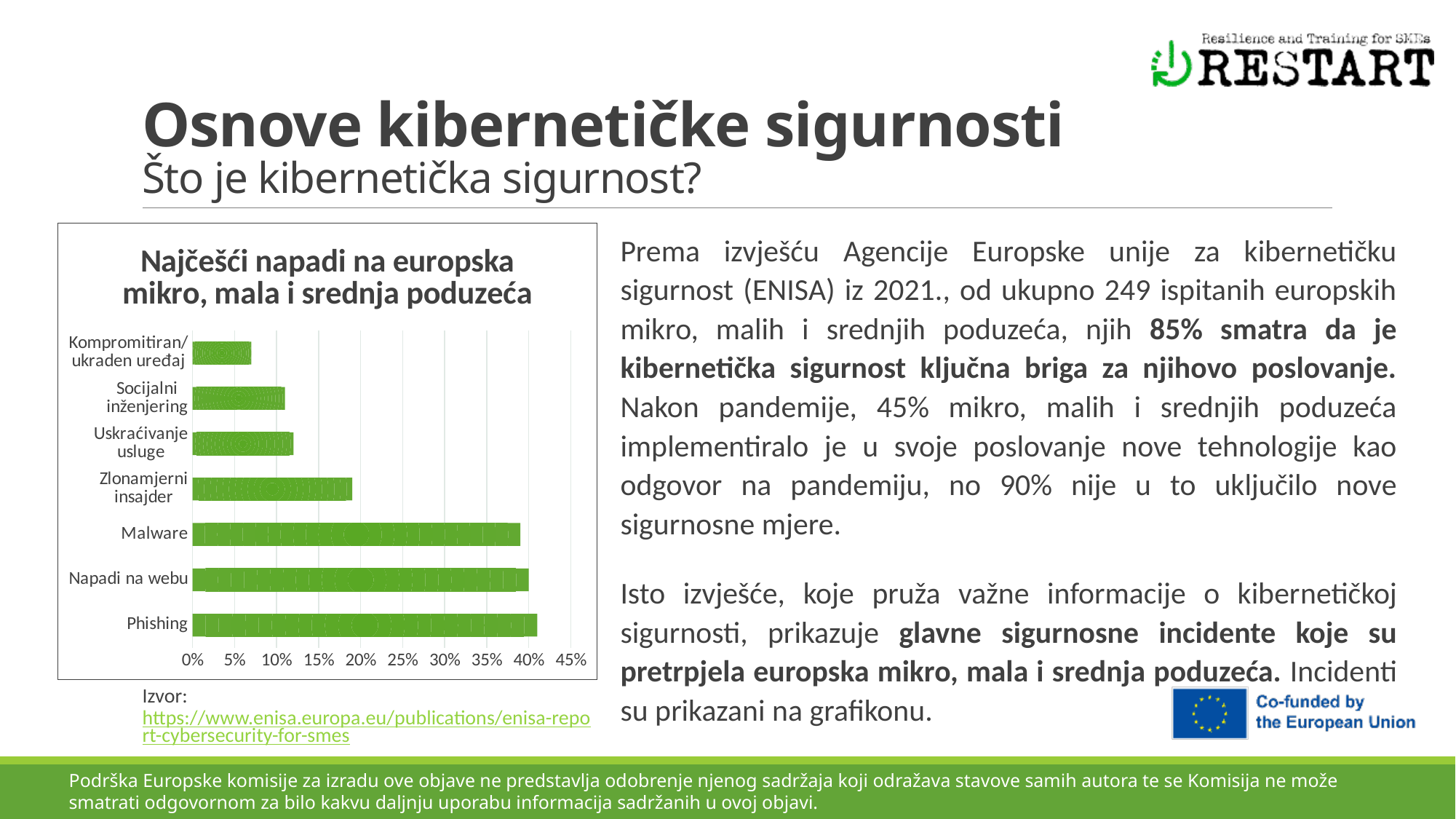
Which is larger, the value for Malware or the value for Zlonamjerni insajder? Malware What kind of chart is shown on the slide? bar chart Which category has the lowest value in the chart? Kompromitiran/ukraden uređaj Is the value for Uskraćivanje usluge greater or less than 15%? less What colour are the bars in the chart? green How many attack categories are plotted in the chart? 7 Is the value for Malware greater or less than 35%? greater Is the value for Kompromitiran/ukraden uređaj greater or less than 10%? less Which is larger, the value for Phishing or the value for Socijalni inženjering? Phishing What is the title of the chart? Najčešći napadi na europska mikro, mala i srednja poduzeća